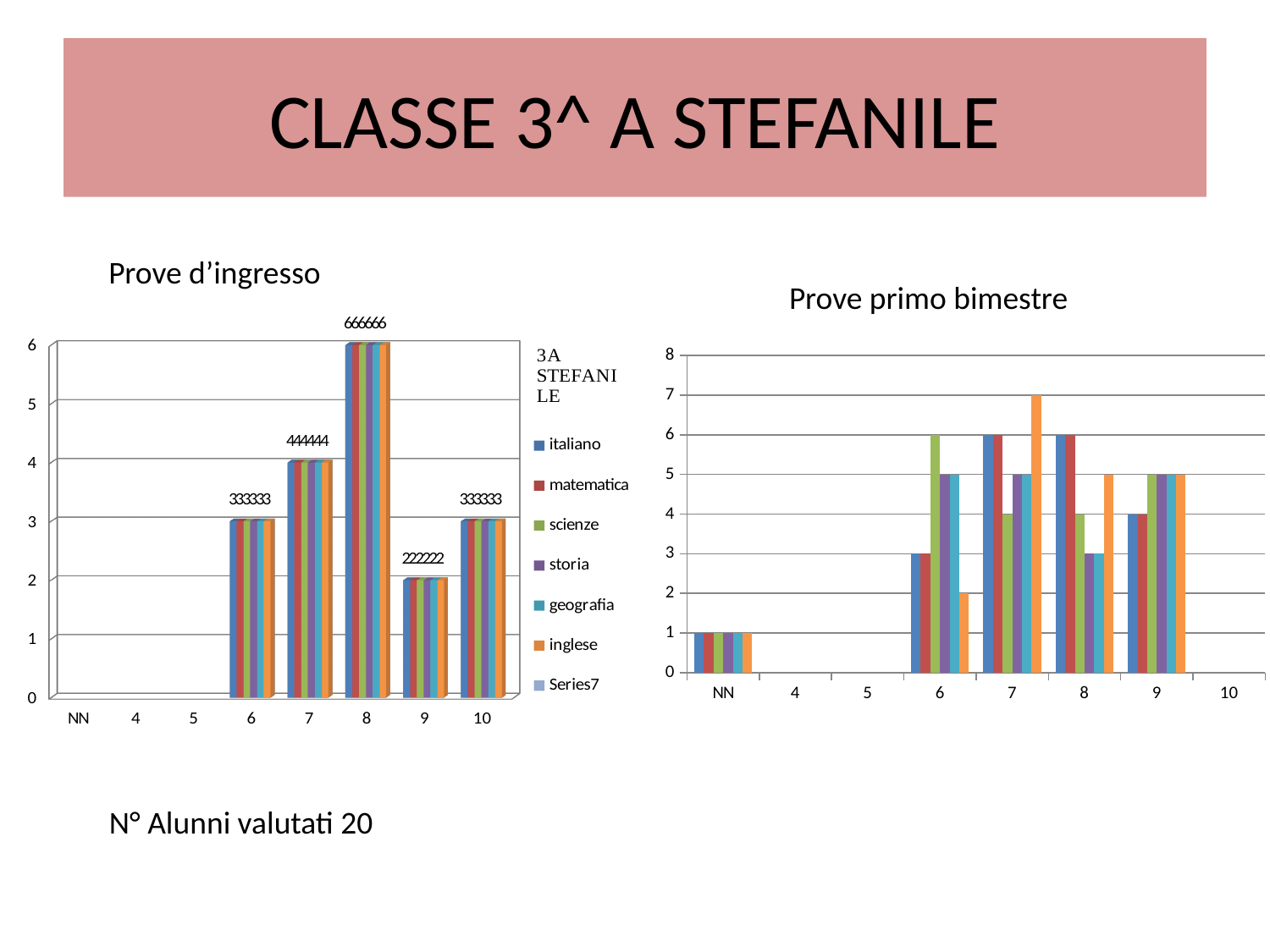
In the 'Prove d'ingresso' chart, are the bars for category 7 or for category 10 taller? 7 In the 'Prove d'ingresso' chart, what is the difference between the bar value for category 8 and the bar value for category 9? 4 What kind of chart is the 'Prove d'ingresso' chart? bar chart In the 'Prove d'ingresso' chart, which category has the highest bars? 8 In the 'Prove primo bimestre' chart, in which category does the tallest bar appear? 7 In the 'Prove d'ingresso' chart, which subjects are listed in the legend? italiano, matematica, scienze, storia, geografia, inglese In the 'Prove primo bimestre' chart, is the orange bar for category 6 greater or less than 3? less In the 'Prove primo bimestre' chart, which categories have no bars at all? 4, 5, 10 In the 'Prove primo bimestre' chart, what value do the bars for category NN reach? 1 In the 'Prove d'ingresso' chart, which category has the lowest non-zero bars? 9 In the 'Prove d'ingresso' chart, what value do the bars for category 8 reach? 6 How many categories are shown on the x axis of the 'Prove primo bimestre' chart? 8